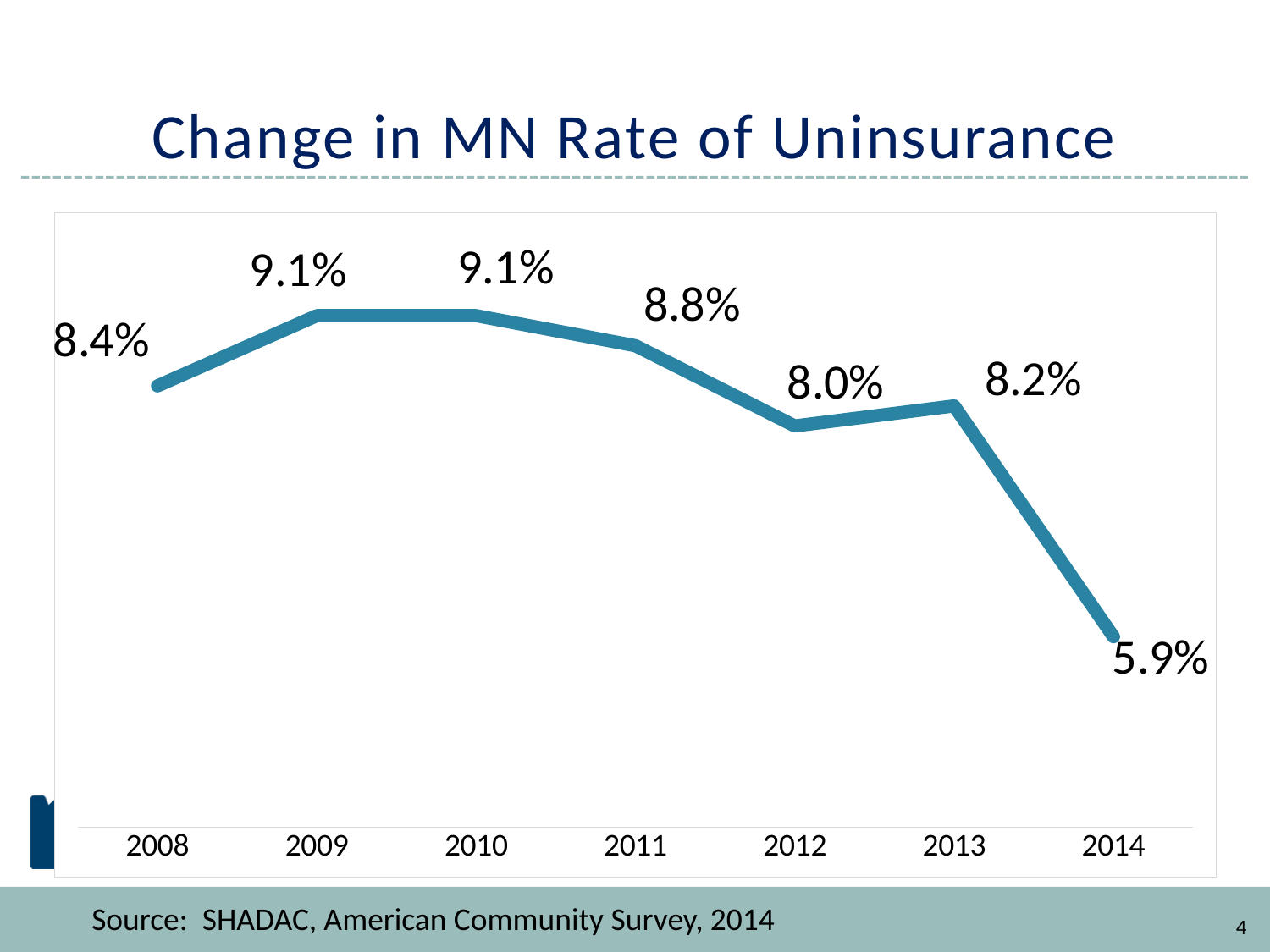
What kind of chart is shown on the slide? Line chart Which year has the lowest rate of uninsurance? 2014 How many years are plotted on the chart? 7 Does the rate of uninsurance rise or fall from 2013 to 2014? Fall Which is larger, the rate in 2012 or the rate in 2013? 2013 What is the MN rate of uninsurance in 2012? 8.0% What is the MN rate of uninsurance in 2011? 8.8% What is the MN rate of uninsurance in 2014? 5.9% What is the difference between the 2009 rate and the 2008 rate? 0.7% What is the title of the chart? Change in MN Rate of Uninsurance What is the difference between the 2013 rate and the 2014 rate? 2.3% What is the MN rate of uninsurance in 2008? 8.4%